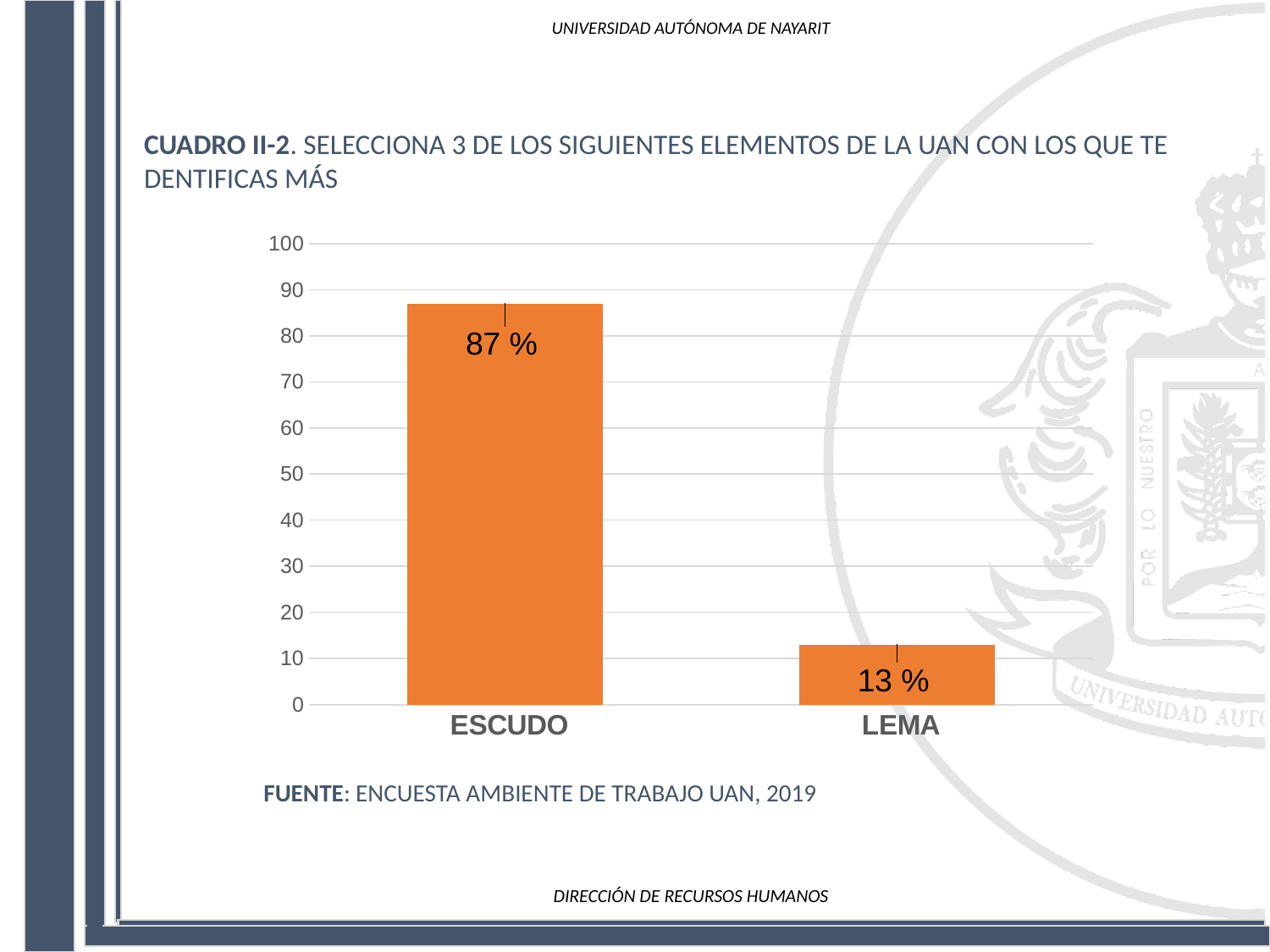
Which is larger, the value for ESCUDO or the value for LEMA? ESCUDO What kind of chart is shown on the slide? bar chart Is the value for ESCUDO greater or less than 80? greater Is the value for LEMA greater or less than 20? less What is the maximum value shown on the vertical axis? 100 What is the value for ESCUDO? 87 % What colour are the bars in the chart? orange How many categories are shown on the x axis? 2 Which category has the lowest value? LEMA What is the difference between the values for ESCUDO and LEMA? 74 % Which category has the highest value? ESCUDO What is the value for LEMA? 13 %